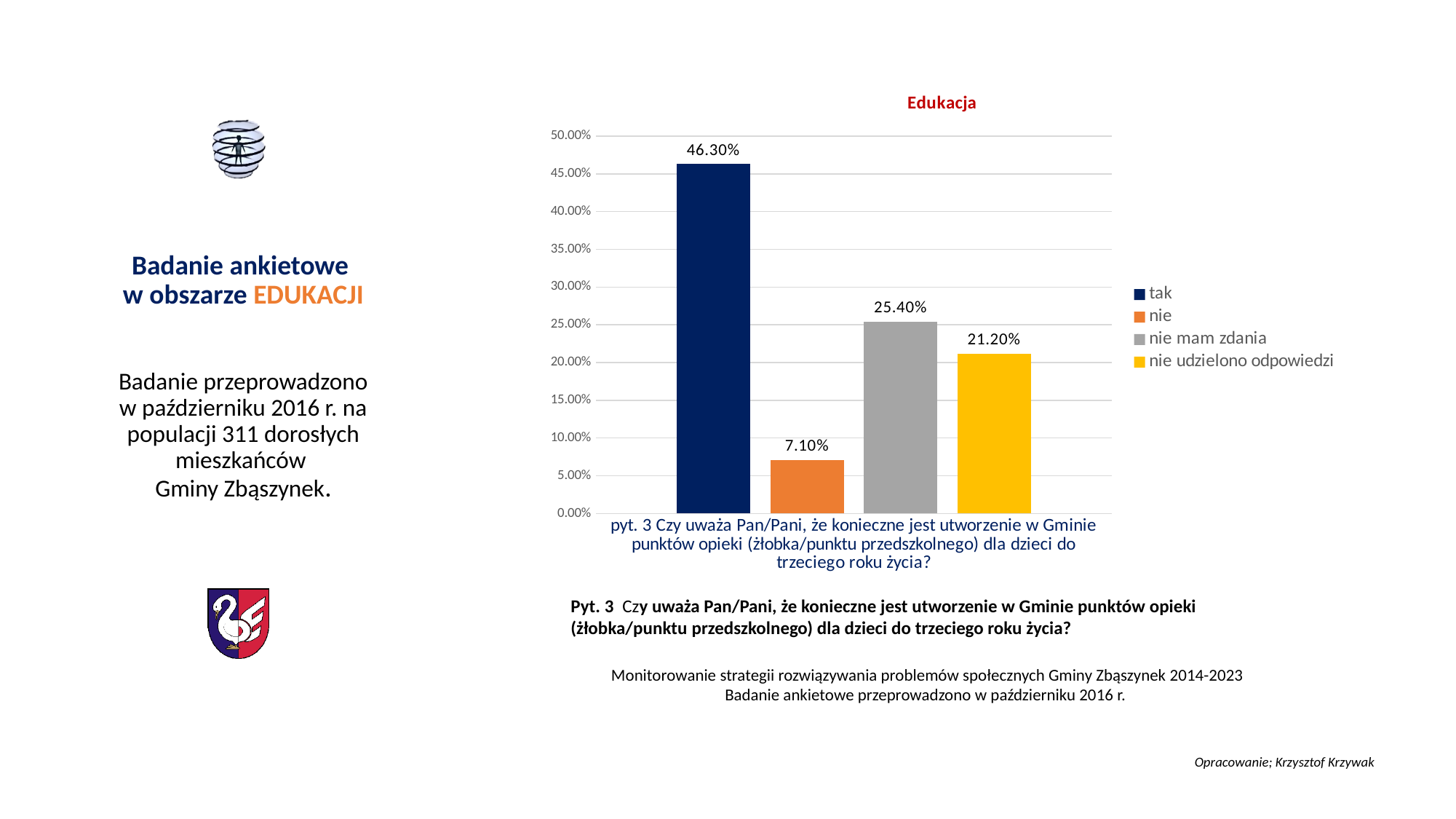
What is the value for "tak" in the Edukacja chart? 46.30% Which is larger in the Edukacja chart: the value for "nie mam zdania" or the value for "nie udzielono odpowiedzi"? nie mam zdania What is the value for "nie" in the Edukacja chart? 7.10% Which response has the lowest value in the Edukacja chart? nie How many series does the legend of the Edukacja chart list? 4 What is the difference between the values for "nie mam zdania" and "nie udzielono odpowiedzi" in the Edukacja chart? 4.20% What is the title of the chart on the slide? Edukacja What kind of chart is shown on the slide? bar chart Which response has the highest value in the Edukacja chart? tak What is the value for "nie mam zdania" in the Edukacja chart? 25.40% What is the difference between the values for "tak" and "nie" in the Edukacja chart? 39.20% What is the value for "nie udzielono odpowiedzi" in the Edukacja chart? 21.20%